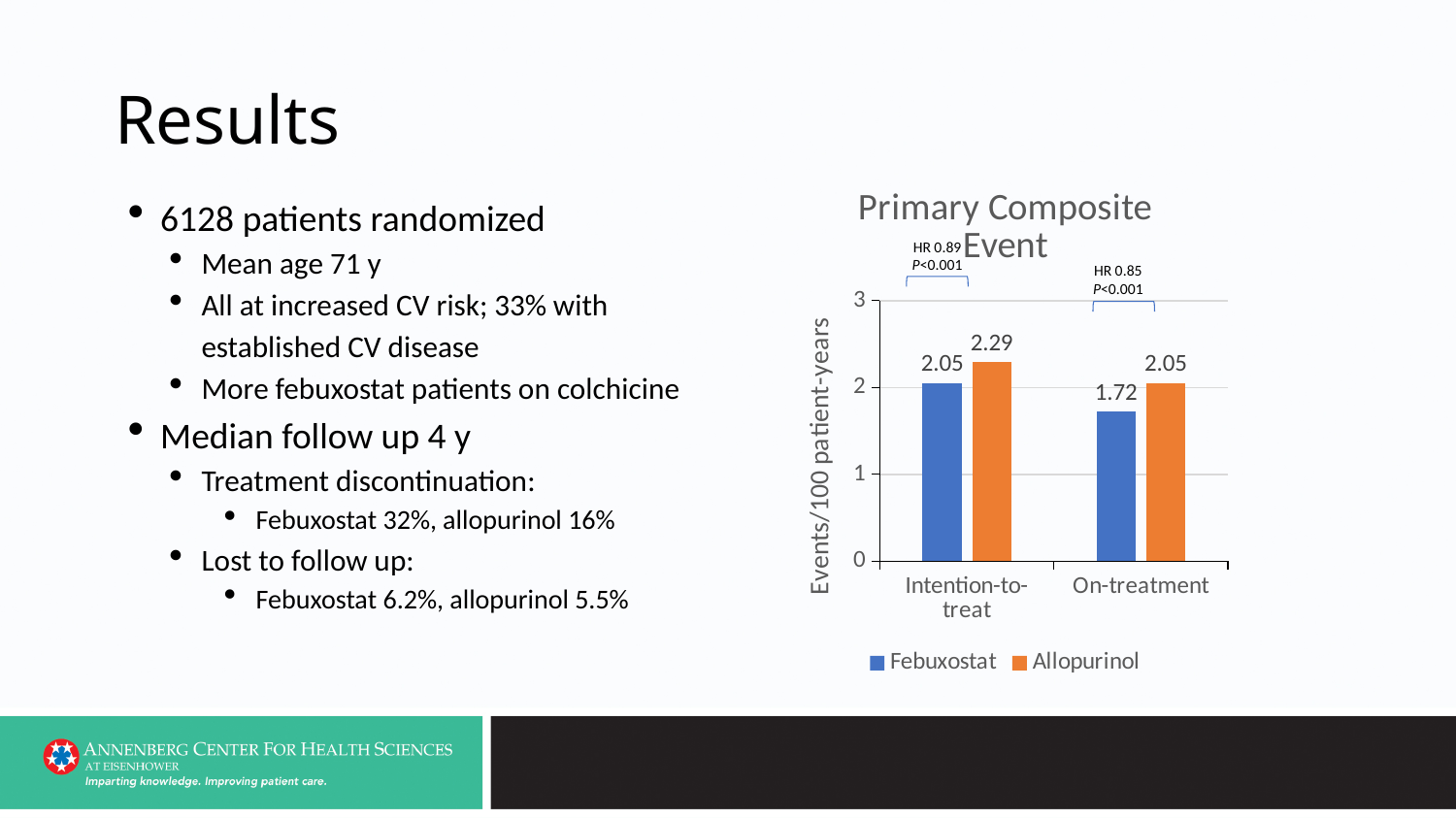
Which bar has the lowest value in the chart? Febuxostat, On-treatment What type of chart is shown on the slide? bar chart How many categories are shown on the x axis? 2 Which is larger for Intention-to-treat, Febuxostat or Allopurinol? Allopurinol What is the Allopurinol value for Intention-to-treat? 2.29 What is the Allopurinol value for On-treatment? 2.05 Is the Febuxostat value for On-treatment greater or less than 2? less What is the difference between the Allopurinol and Febuxostat values for On-treatment? 0.33 How many series does the legend list? 2 Which bar has the highest value in the chart? Allopurinol, Intention-to-treat What is the Febuxostat value for On-treatment? 1.72 What is the Febuxostat value for Intention-to-treat? 2.05